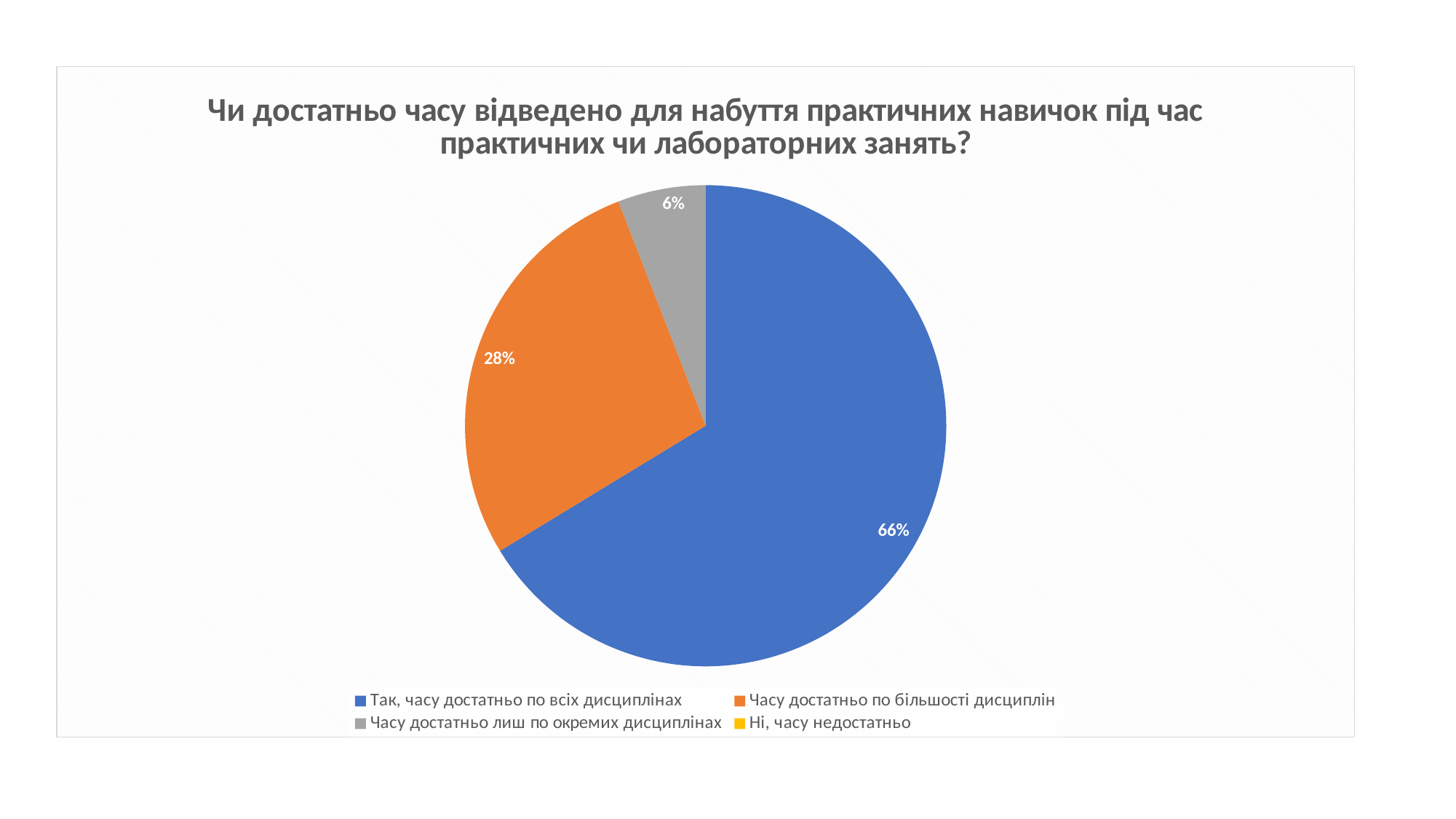
What is the difference in percentage points between the "Так, часу достатньо по всіх дисциплінах" slice and the "Часу достатньо по більшості дисциплін" slice? 38 How many entries does the legend list? 4 What is the title of the chart? Чи достатньо часу відведено для набуття практичних навичок під час практичних чи лабораторних занять? Which slice is larger: "Часу достатньо по більшості дисциплін" or "Часу достатньо лиш по окремих дисциплінах"? Часу достатньо по більшості дисциплін Which of the labelled slices is the smallest? Часу достатньо лиш по окремих дисциплінах Which category has the largest slice of the pie? Так, часу достатньо по всіх дисциплінах What kind of chart is shown on the slide? pie chart What colour is the slice for "Часу достатньо по більшості дисциплін"? orange What share of the pie is labelled for "Часу достатньо лиш по окремих дисциплінах"? 6% Is the share for "Так, часу достатньо по всіх дисциплінах" greater or less than 50%? greater What share of the pie is labelled for "Часу достатньо по більшості дисциплін"? 28% What share of the pie is labelled for "Так, часу достатньо по всіх дисциплінах"? 66%